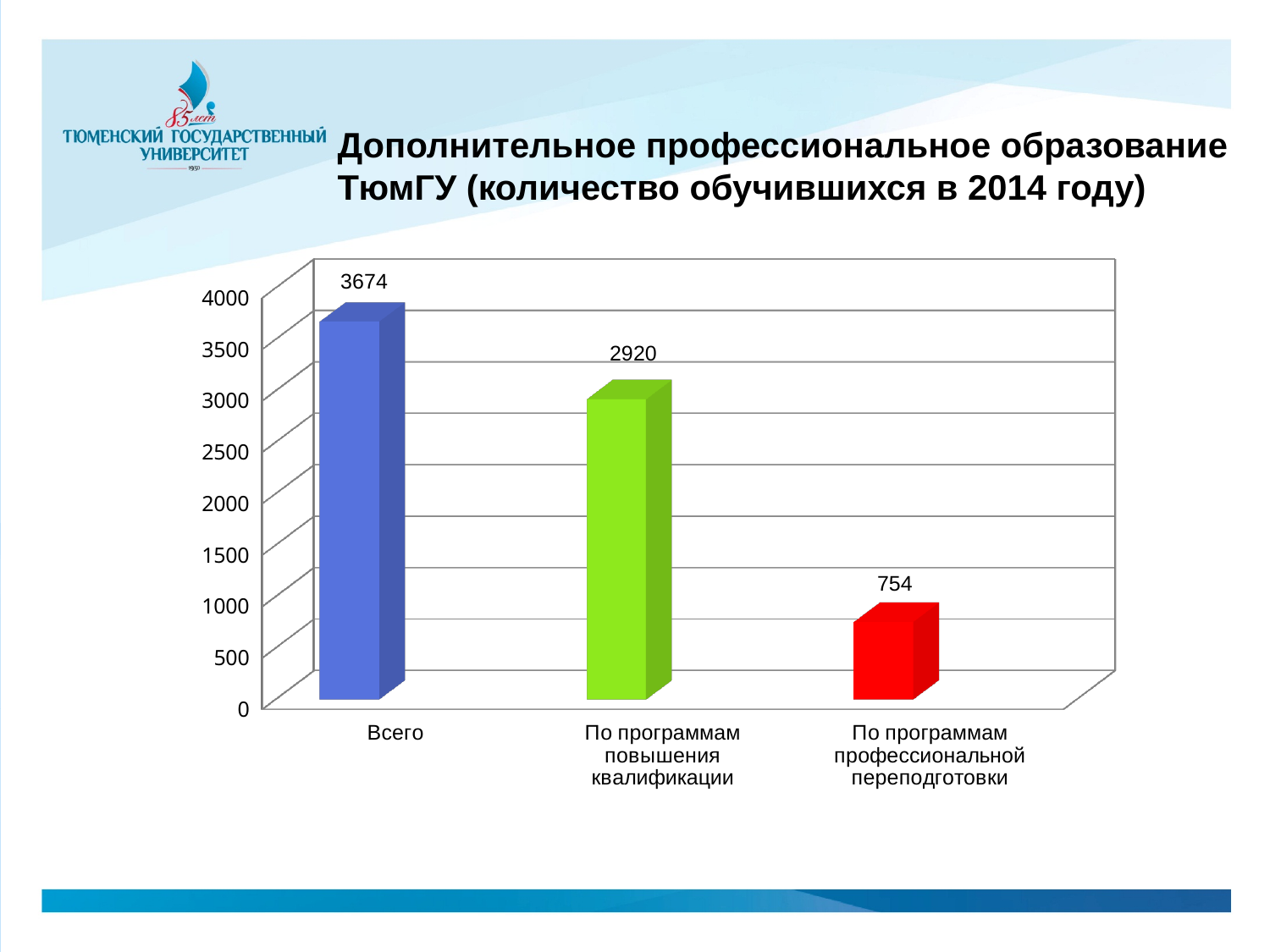
Which category has the highest value? Всего What is the difference between the values for По программам повышения квалификации and По программам профессиональной переподготовки? 2166 How many categories are shown on the chart? 3 What is the value for По программам повышения квалификации? 2920 What is the value for По программам профессиональной переподготовки? 754 What is the difference between the values for Всего and По программам повышения квалификации? 754 What kind of chart is shown on the slide? bar chart Which is larger, the value for По программам повышения квалификации or the value for По программам профессиональной переподготовки? По программам повышения квалификации Which category has the lowest value? По программам профессиональной переподготовки What is the value for Всего? 3674 Is the value for По программам профессиональной переподготовки greater or less than 1000? less What colour is the bar for По программам профессиональной переподготовки? red